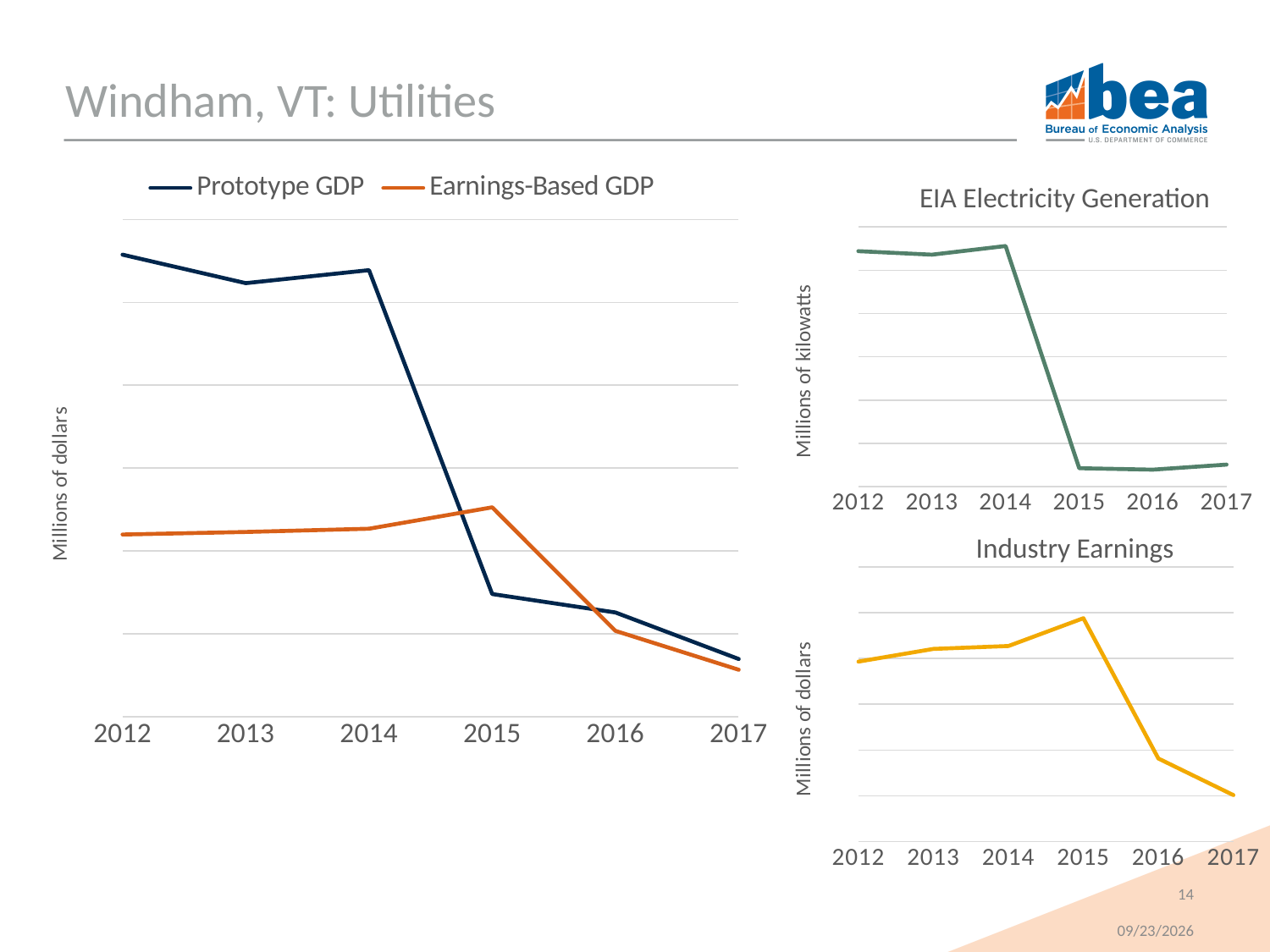
How many years are plotted in the Industry Earnings chart? 6 In the left chart, which year has the highest Earnings-Based GDP value? 2015 In the left chart, in 2012, which series is larger: Prototype GDP or Earnings-Based GDP? Prototype GDP In the left chart, in 2015, which series is larger: Prototype GDP or Earnings-Based GDP? Earnings-Based GDP How many series does the legend of the left chart list? 2 In the left chart, which year has the highest Prototype GDP value? 2012 What kind of chart is the large chart on the left of the slide? Line chart In the EIA Electricity Generation chart, which year has the highest value? 2014 What is the y-axis label of the EIA Electricity Generation chart? Millions of kilowatts In the EIA Electricity Generation chart, do values rise or fall from 2014 to 2015? Fall In the left chart, which year has the lowest Prototype GDP value? 2017